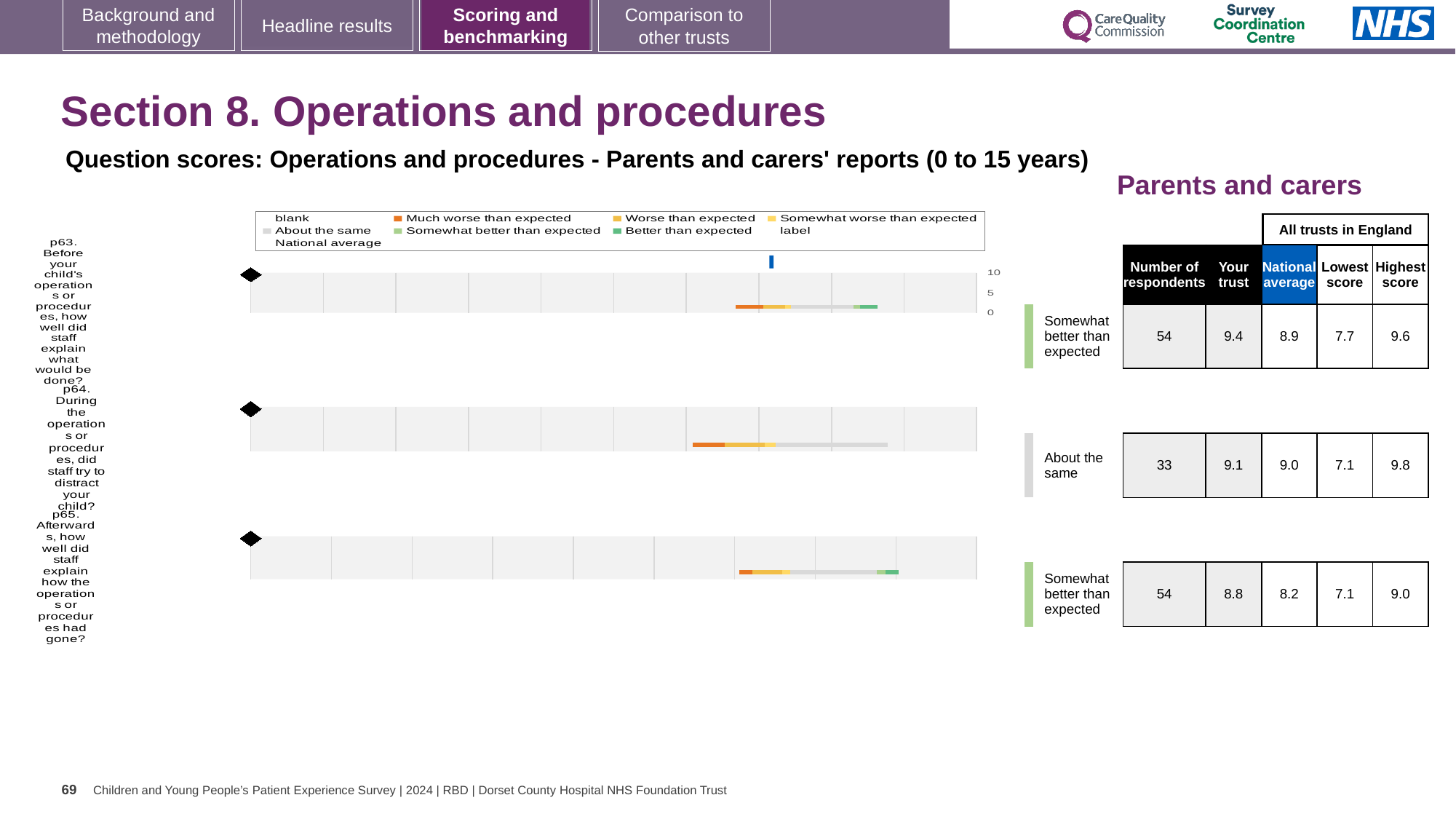
Which question has the lowest 'Your trust' score? p65 What kind of chart is shown on the slide? bar chart What is the 'Your trust' score for p63 (Before your child's operations or procedures, how well did staff explain what would be done?)? 9.4 What benchmark category is p64 rated as? About the same What is the highest score across all trusts in England for p64? 9.8 How many entries does the chart legend list? 9 What is the difference between the 'Your trust' score and the national average for p63? 0.5 Which is larger: the 'Your trust' score for p63 or for p64? p63 Which question has the highest 'Your trust' score? p63 How many questions (rows) are plotted in the chart? 3 What is the number of respondents for p65 (Afterwards, how well did staff explain how the operations or procedures had gone?)? 54 What is the national average for p64 (During the operations or procedures, did staff try to distract your child?)? 9.0